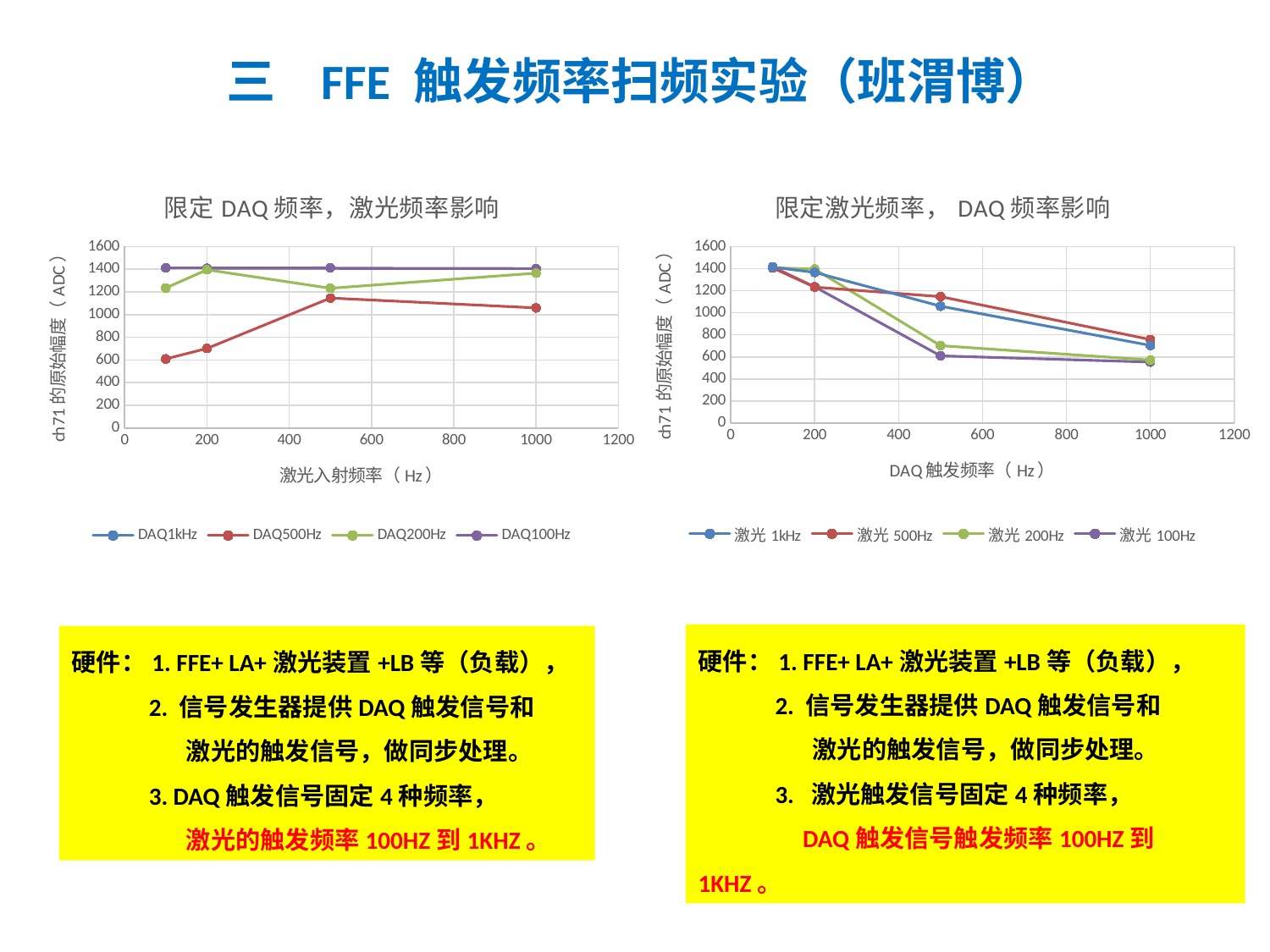
In the left chart (限定 DAQ 频率，激光频率影响), which series is lower at 200 Hz, DAQ500Hz or DAQ200Hz? DAQ500Hz What kind of chart is the left chart titled 限定 DAQ 频率，激光频率影响? line chart In the right chart (限定激光频率， DAQ 频率影响), is the 激光 500Hz value at 500 Hz greater or less than 1000? greater In the left chart (限定 DAQ 频率，激光频率影响), is the DAQ500Hz value at 100 Hz greater or less than 800? less In the right chart (限定激光频率， DAQ 频率影响), does the 激光 100Hz series generally rise or fall as DAQ trigger frequency increases? fall What is the x-axis label of the right chart (限定激光频率， DAQ 频率影响)? DAQ 触发频率（Hz） In the right chart (限定激光频率， DAQ 频率影响), is the 激光 200Hz value at 500 Hz greater or less than 1000? less In the left chart (限定 DAQ 频率，激光频率影响), does the DAQ500Hz series rise or fall between 100 Hz and 500 Hz? rise How many series does the legend of the right chart (限定激光频率， DAQ 频率影响) list? 4 In the right chart (限定激光频率， DAQ 频率影响), which series is higher at 500 Hz, 激光 500Hz or 激光 100Hz? 激光 500Hz What is the title of the left chart? 限定 DAQ 频率，激光频率影响